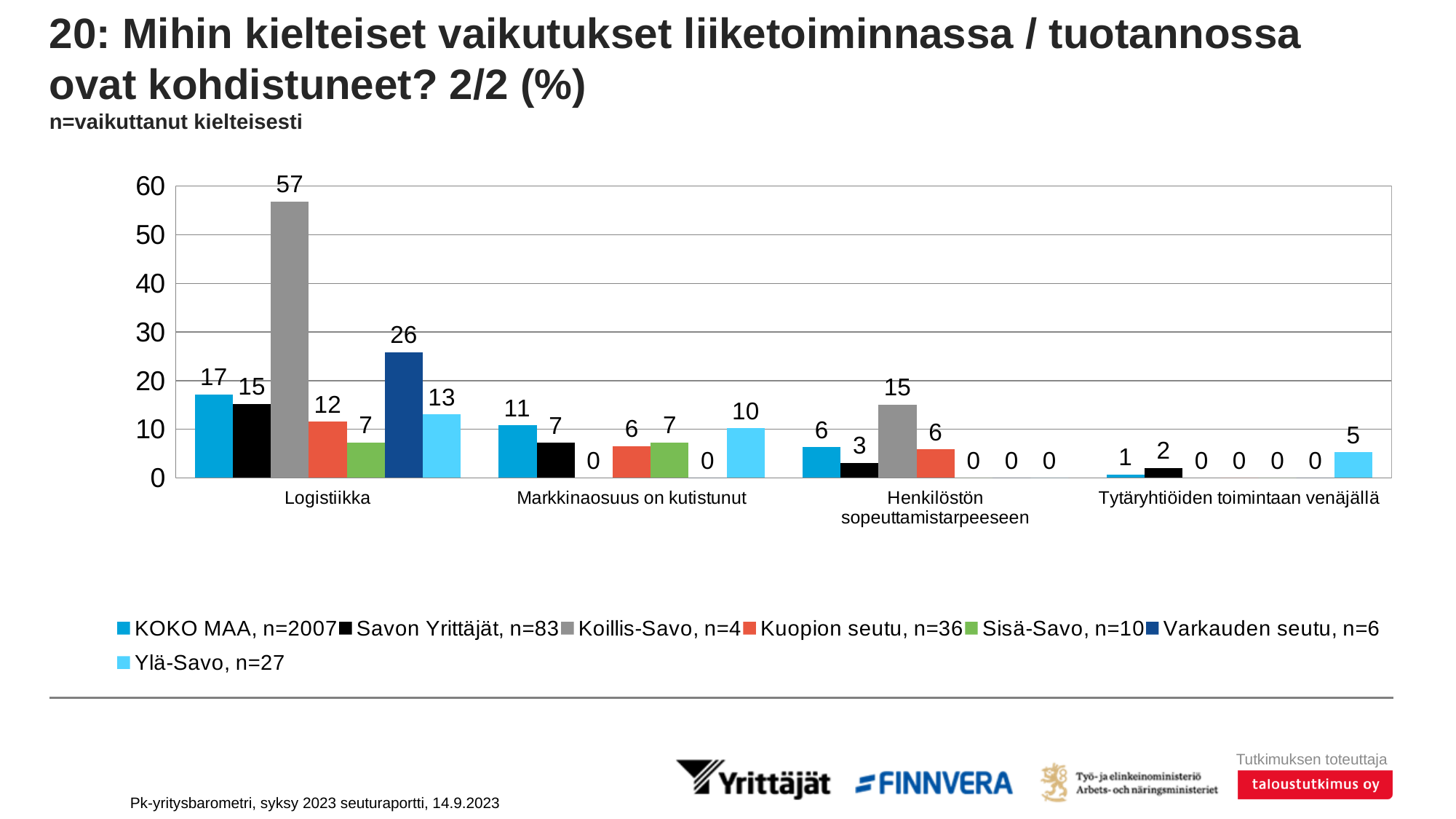
Which is larger in the Markkinaosuus on kutistunut category: KOKO MAA or Savon Yrittäjät? KOKO MAA What kind of chart is shown on the slide? Bar chart What is the value for Koillis-Savo in the Henkilöstön sopeuttamistarpeeseen category? 15 How many series does the legend list? 7 Which series has the highest value in the Logistiikka category? Koillis-Savo, n=4 What is the difference between the KOKO MAA value and the Savon Yrittäjät value in the Logistiikka category? 2 What is the value for Varkauden seutu in the Logistiikka category? 26 What is the value for Koillis-Savo in the Logistiikka category? 57 Which series has the lowest value in the Tytäryhtiöiden toimintaan venäjällä category among those with a non-zero value? KOKO MAA, n=2007 How many categories are shown on the x axis? 4 What is the value for Ylä-Savo in the Tytäryhtiöiden toimintaan venäjällä category? 5 What is the value for Ylä-Savo in the Markkinaosuus on kutistunut category? 10